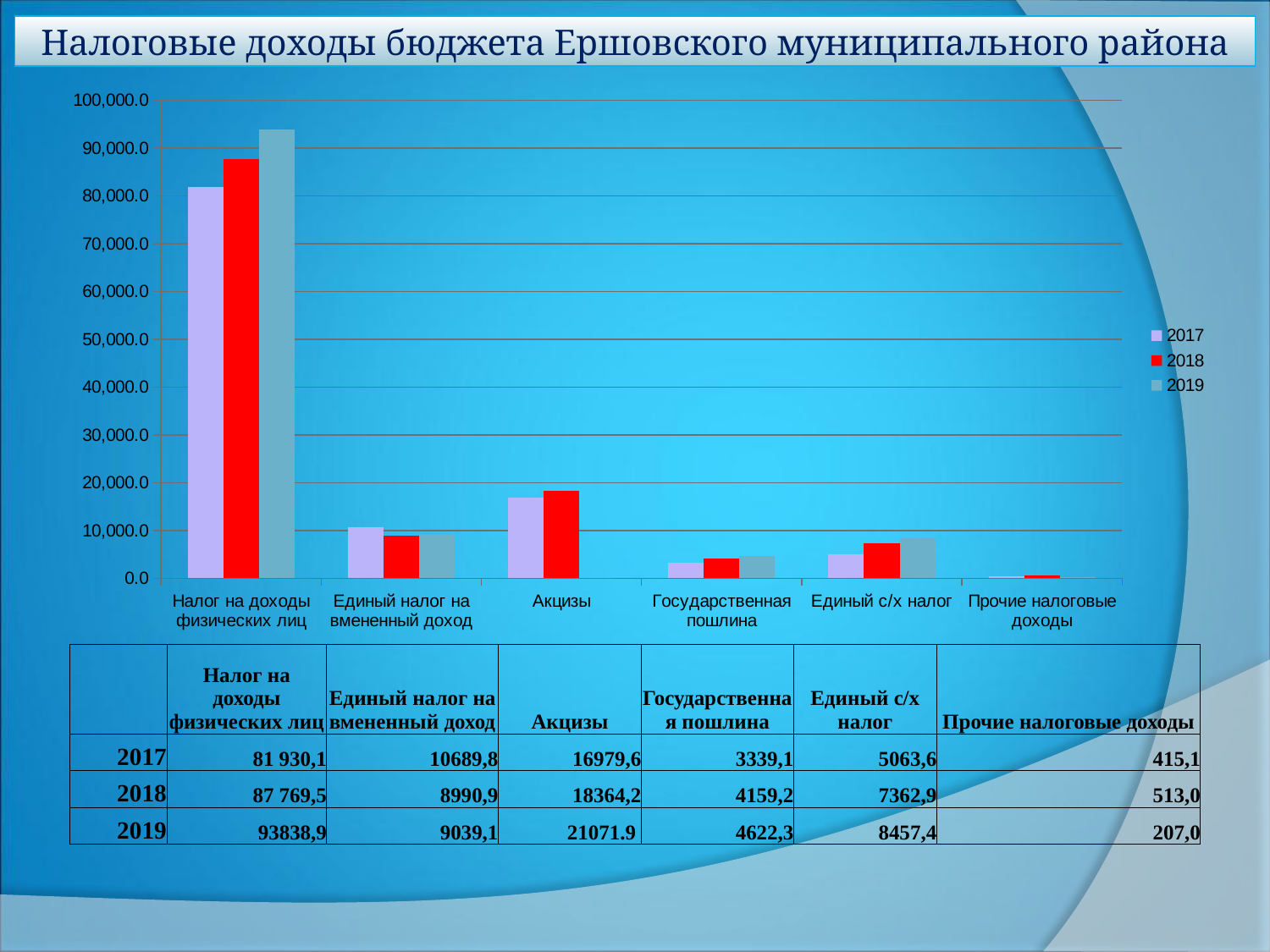
Which category has the lowest value in 2017? Прочие налоговые доходы Is the 2019 value for Налог на доходы физических лиц greater or less than 90,000.0? greater What is the value for Налог на доходы физических лиц in 2018? 87 769,5 By how much did Государственная пошлина increase from 2017 to 2019? 1283,2 What kind of chart is shown on the slide? bar chart Which category has the highest value in 2019? Налог на доходы физических лиц How many series does the legend list? 3 How many tax categories are shown on the x axis of the chart? 6 Does the value for Налог на доходы физических лиц rise or fall from 2017 to 2019? rise For Единый налог на вмененный доход, which year has the larger value, 2017 or 2018? 2017 What is the value for Акцизы in 2017? 16979,6 What is the value for Единый с/х налог in 2019? 8457,4